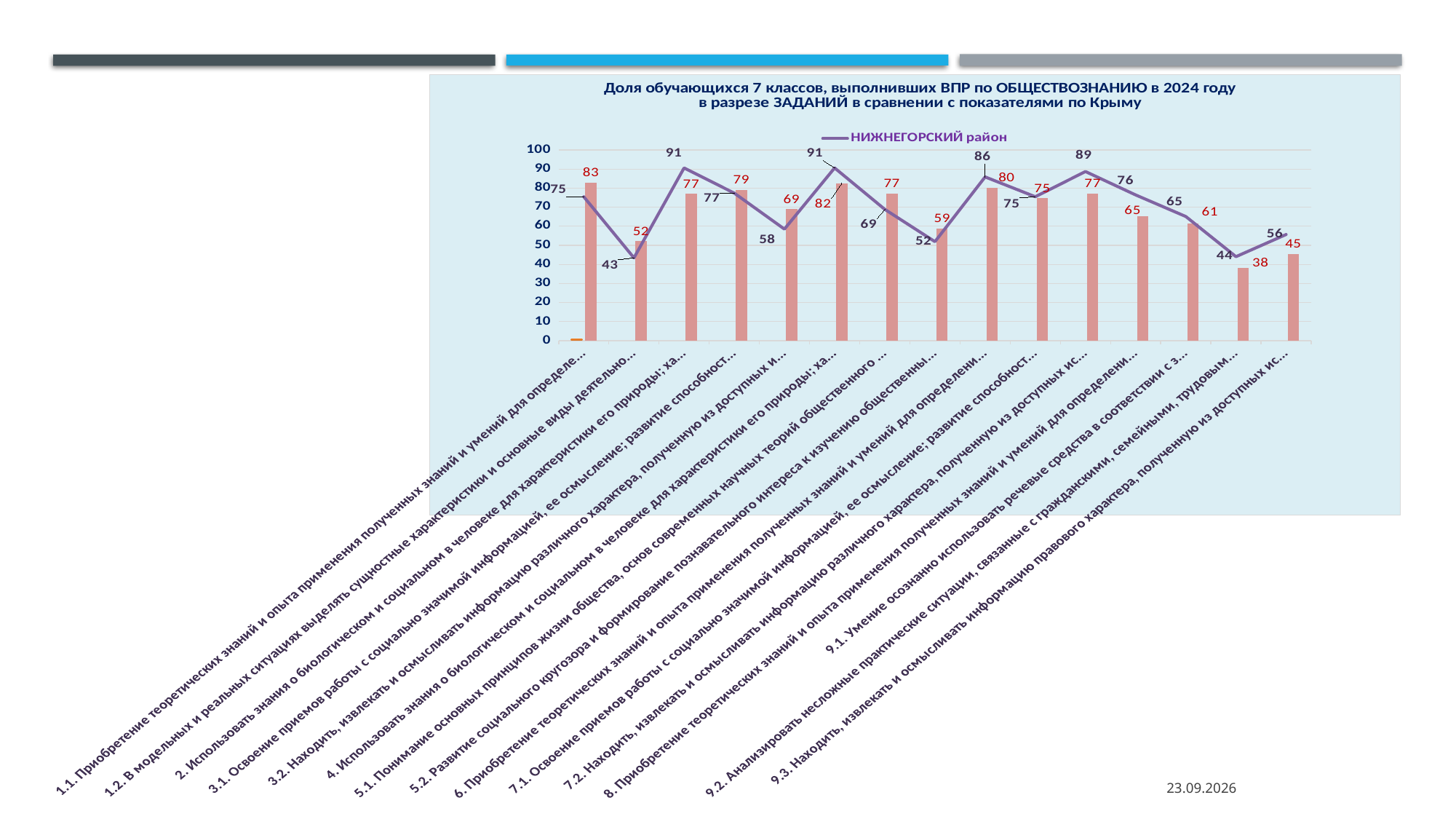
What is the value of the НИЖНЕГОРСКИЙ район line for task 1.2? 43 What is the value of the НИЖНЕГОРСКИЙ район line for task 7.2? 89 What kind of chart is this? a combined bar and line chart Which task has the lowest bar value? 9.2 Which task has the lowest value on the НИЖНЕГОРСКИЙ район line? 1.2 Does the НИЖНЕГОРСКИЙ район line rise or fall from task 9.1 to task 9.2? fall For task 9.1, which is larger: the bar value or the НИЖНЕГОРСКИЙ район line value? the line value (65) What is the value of the bar for task 9.2? 38 For task 1.1, what is the difference between the bar value and the НИЖНЕГОРСКИЙ район line value? 8 How many series does the legend list? 1 Which task has the highest bar value? 1.1 How many tasks (categories) are shown on the x axis? 15